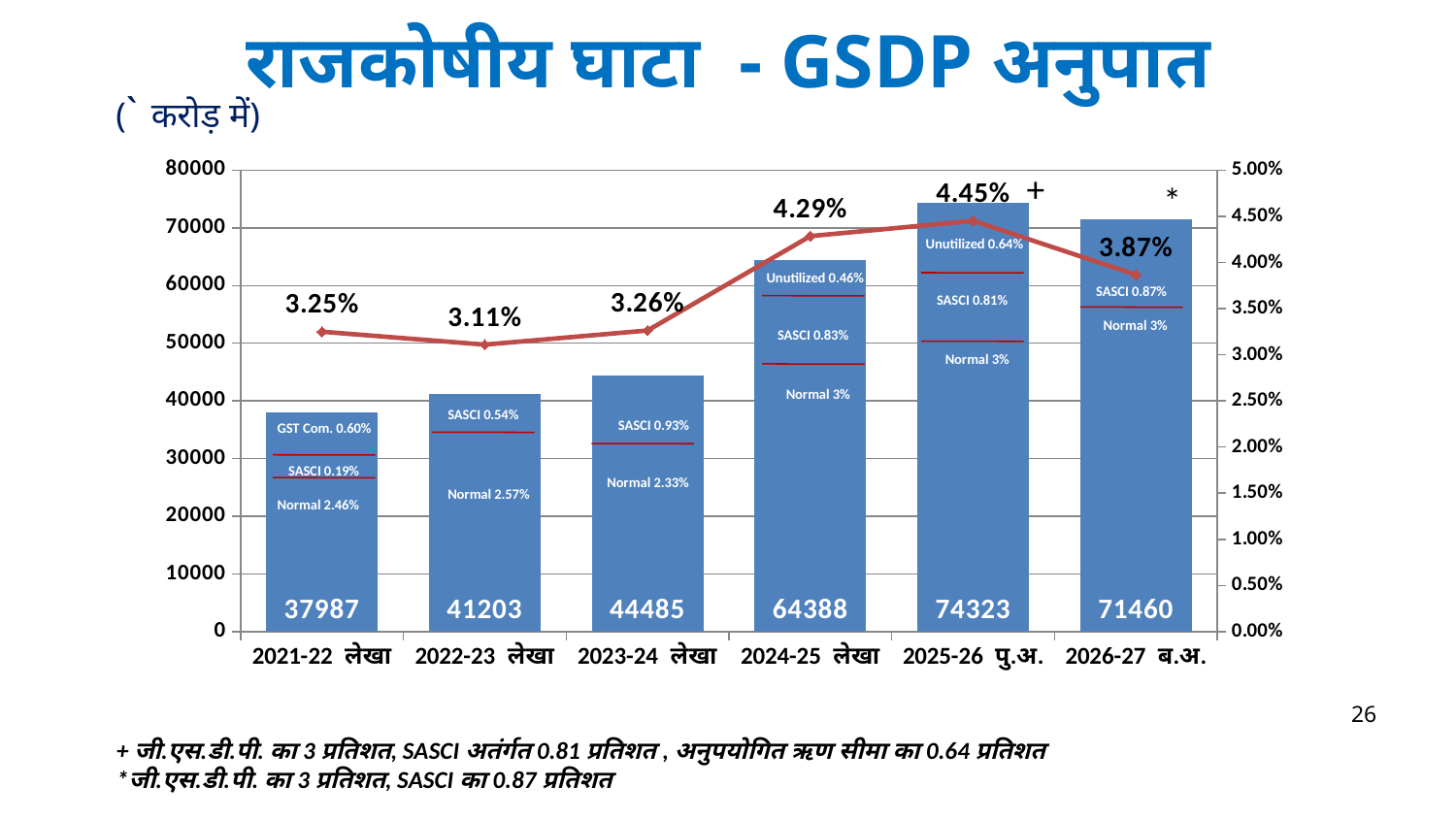
Does the fiscal deficit value (in crore) rise or fall from 2021-22 लेखा to 2025-26 पु.अ.? Rise Which is larger, the fiscal deficit to GSDP ratio for 2023-24 लेखा or for 2021-22 लेखा? 2023-24 लेखा What is the difference between the fiscal deficit values for 2025-26 पु.अ. and 2026-27 ब.अ.? 2863 How many years are shown on the x axis of the chart? 6 What is the fiscal deficit value (in crore) shown for 2021-22 लेखा? 37987 Which year has the lowest fiscal deficit to GSDP ratio? 2022-23 लेखा What fiscal deficit to GSDP ratio is shown for 2026-27 ब.अ.? 3.87% Which year has the highest fiscal deficit value (in crore)? 2025-26 पु.अ. What is the difference between the fiscal deficit to GSDP ratio for 2025-26 पु.अ. and 2024-25 लेखा? 0.16% What is the fiscal deficit value (in crore) shown for 2024-25 लेखा? 64388 What kind of chart is used to show the fiscal deficit values in crore? Bar chart What fiscal deficit to GSDP ratio is shown for 2022-23 लेखा? 3.11%